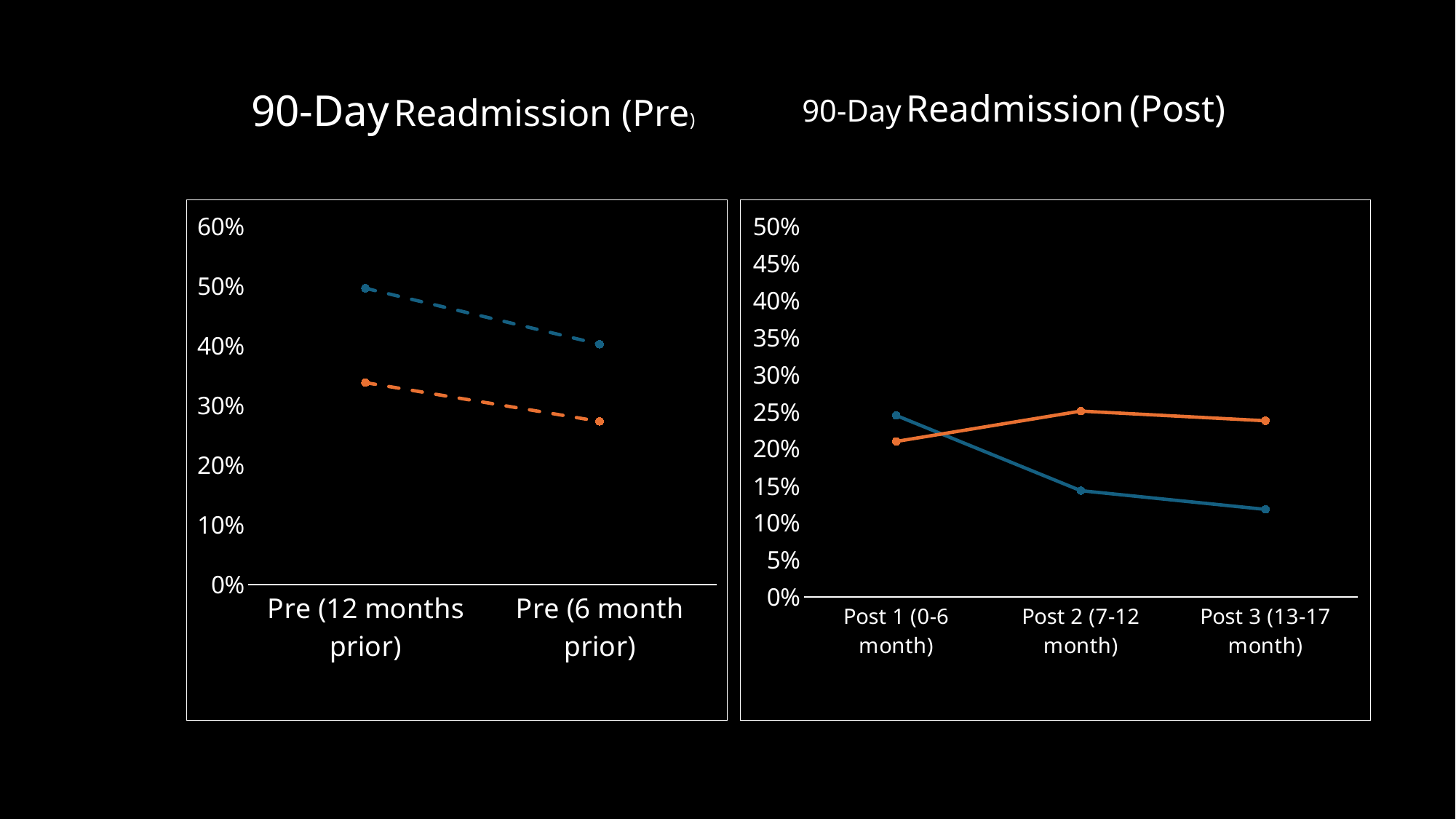
In the 90-Day Readmission (Pre) chart, is the orange series value for Pre (6 month prior) greater or less than 40%? less In the 90-Day Readmission (Pre) chart, which series has the higher value at Pre (12 months prior), blue or orange? blue In the 90-Day Readmission (Post) chart, at which category is the blue series highest? Post 1 (0-6 month) How many categories are shown on the x axis of the 90-Day Readmission (Pre) chart? 2 In the 90-Day Readmission (Pre) chart, is the blue series value for Pre (12 months prior) greater or less than 40%? greater In the 90-Day Readmission (Post) chart, is the blue series value for Post 2 (7-12 month) greater or less than 20%? less How many categories are shown on the x axis of the 90-Day Readmission (Post) chart? 3 In the 90-Day Readmission (Post) chart, which series has the higher value at Post 3 (13-17 month), blue or orange? orange In the 90-Day Readmission (Pre) chart, does the blue series rise or fall from Pre (12 months prior) to Pre (6 month prior)? fall In the 90-Day Readmission (Post) chart, does the blue series rise or fall from Post 1 to Post 3? fall What type of chart is the 90-Day Readmission (Pre) chart? line chart